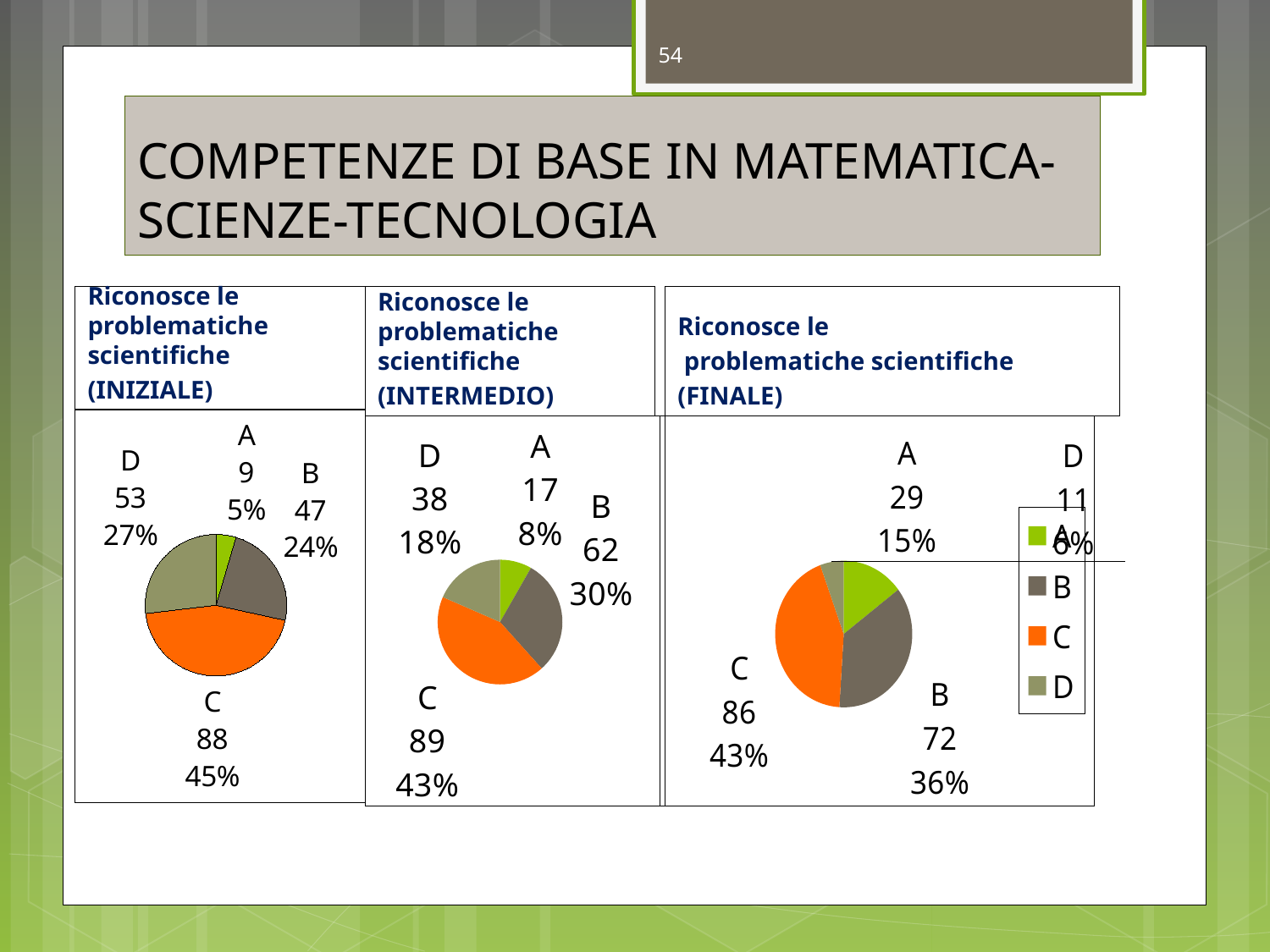
In the INTERMEDIO pie chart, what percentage share does category A have? 8% In the FINALE pie chart, which is larger, the value for B or the value for C? C What type of chart is used in the INTERMEDIO panel? Pie chart In the FINALE pie chart, what percentage share does category B have? 36% In the INIZIALE pie chart, which category has the smallest slice? A In the FINALE pie chart, what is the value for category A? 29 In the INTERMEDIO pie chart, what is the value for category B? 62 In the INIZIALE pie chart, what percentage share does category D have? 27% In the INTERMEDIO pie chart, which category has the largest slice? C In the INIZIALE pie chart, what is the value for category C? 88 How many categories does the INIZIALE pie chart show? 4 In the INTERMEDIO pie chart, what is the difference between the values for C and D? 51